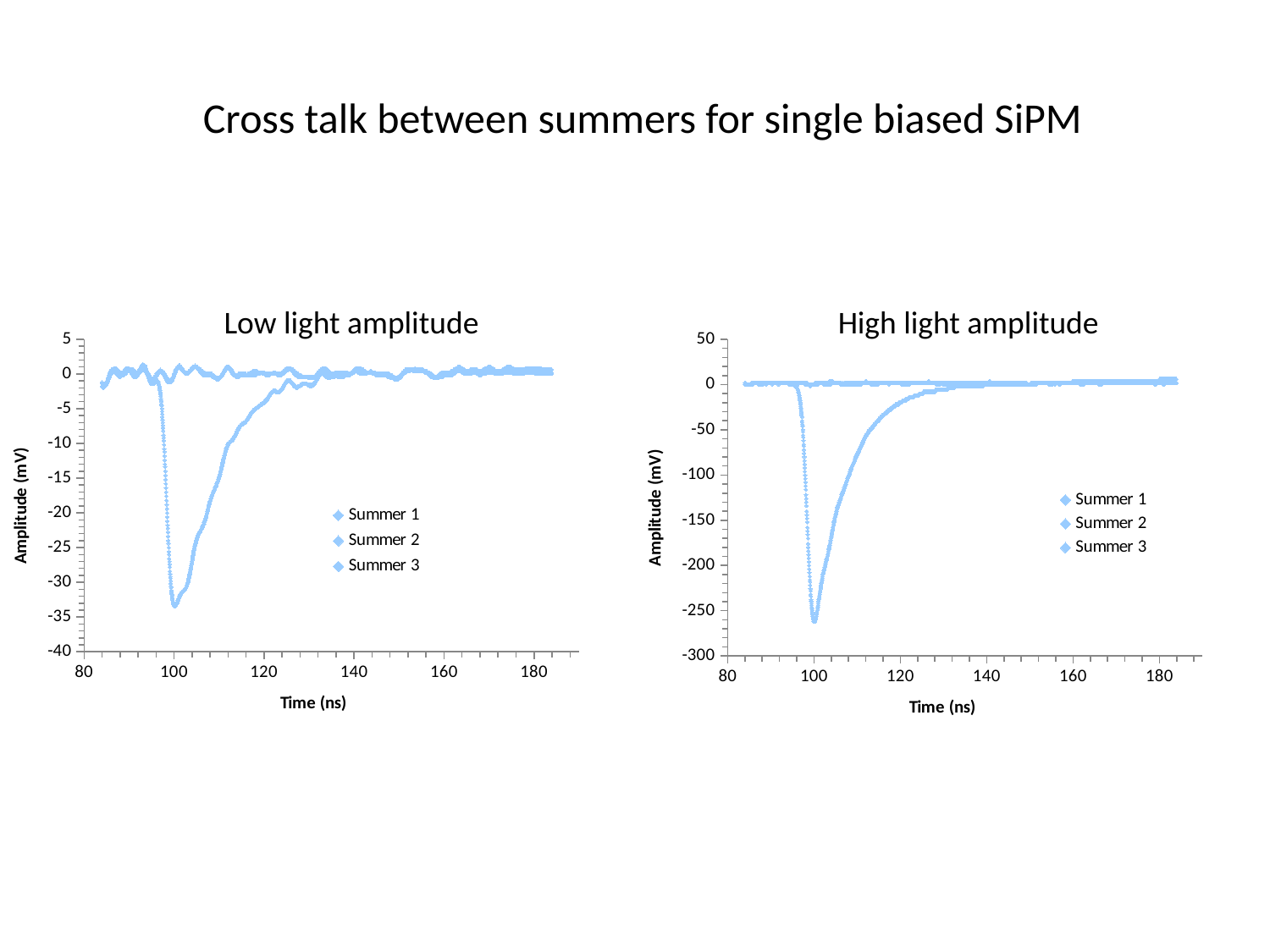
In the 'High light amplitude' chart, is the minimum amplitude reached by the pulse greater or less than -250 mV? less In the 'High light amplitude' chart, how many series does the legend list? 3 In the 'Low light amplitude' chart, what is the highest value shown on the y axis? 5 In the 'High light amplitude' chart, what is the lowest value shown on the y axis? -300 What kind of chart is the 'Low light amplitude' chart? Scatter chart In the 'Low light amplitude' chart, is the minimum amplitude reached by the pulse greater or less than -30 mV? less What is the title of the left chart? Low light amplitude In the 'Low light amplitude' chart, how many series does the legend list? 3 In the 'High light amplitude' chart, is the minimum amplitude reached by the pulse greater or less than -300 mV? greater What is the title of the right chart? High light amplitude In the 'High light amplitude' chart, does the amplitude of the large pulse rise or fall between 100 ns and 120 ns? rise